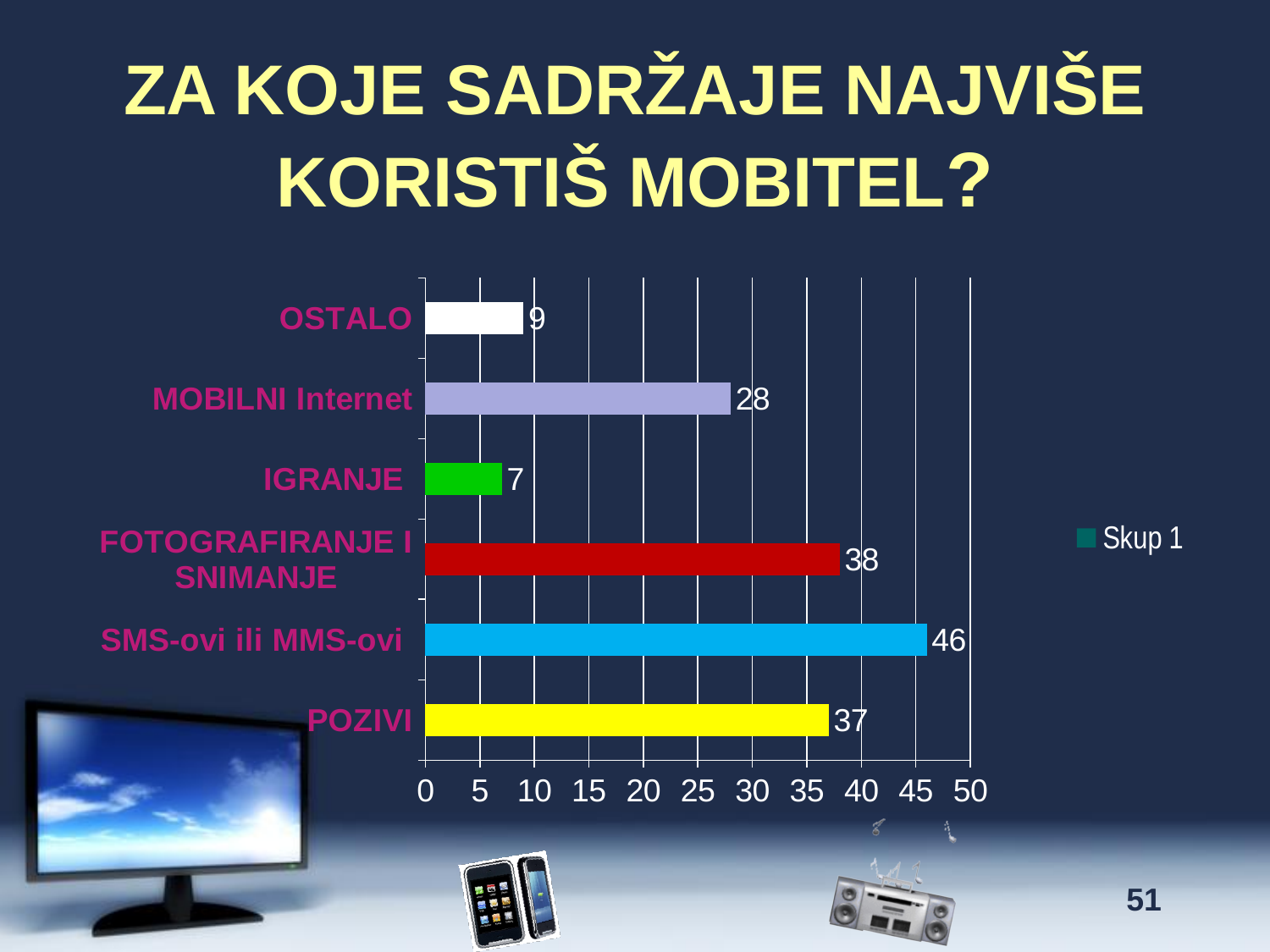
What is the value for IGRANJE? 7 What is the value for MOBILNI Internet? 28 Which category has the lowest value? IGRANJE Which category has the highest value? SMS-ovi ili MMS-ovi Which is larger, the value for MOBILNI Internet or the value for OSTALO? MOBILNI Internet What is the difference between the values for SMS-ovi ili MMS-ovi and FOTOGRAFIRANJE I SNIMANJE? 8 What is the value for POZIVI? 37 What is the legend entry shown next to the chart? Skup 1 Is the value for FOTOGRAFIRANJE I SNIMANJE greater or less than 35? greater What kind of chart is shown on the slide? bar chart What is the value for SMS-ovi ili MMS-ovi? 46 How many categories are shown in the chart? 6